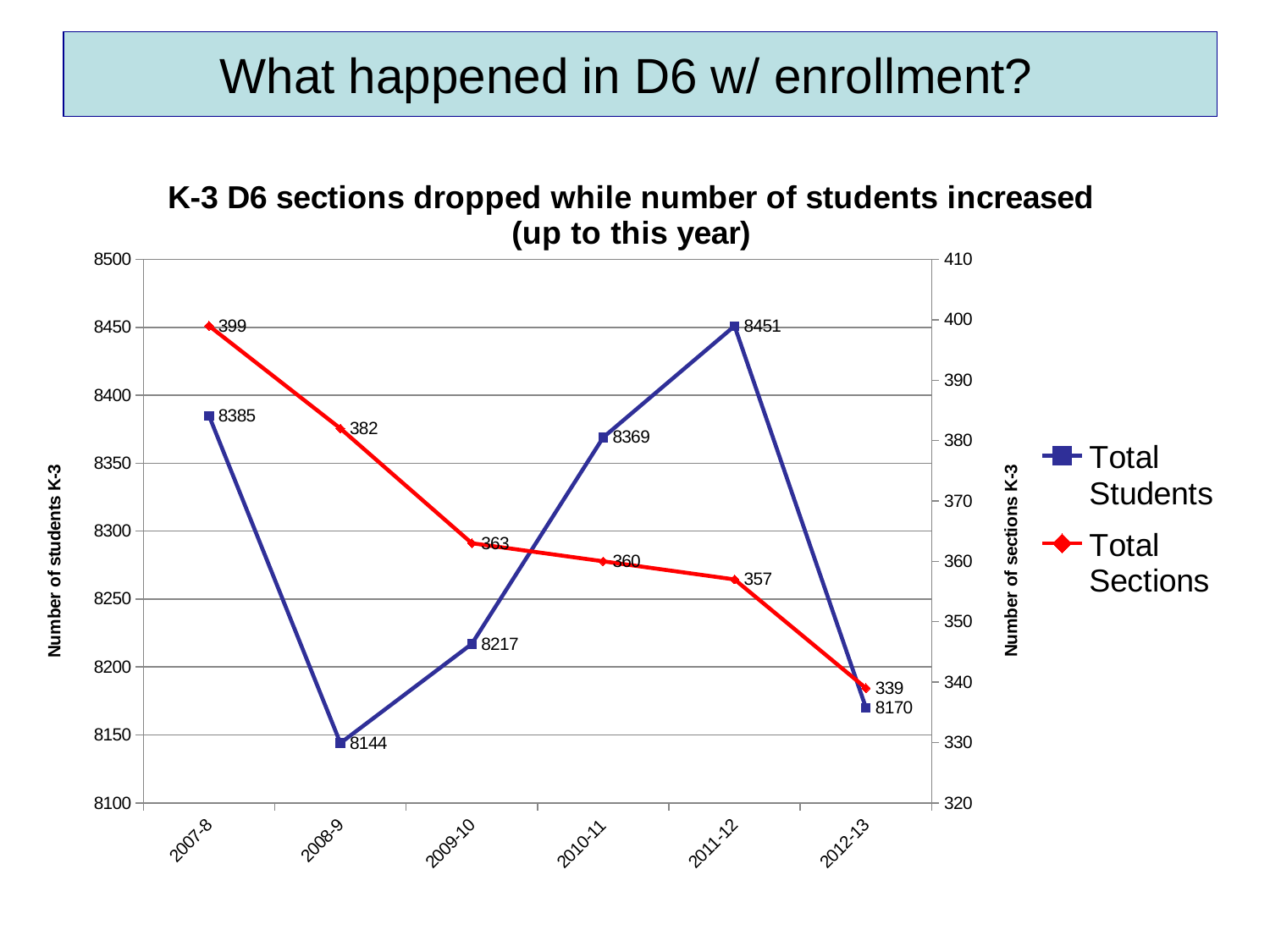
Which year has the lowest value for Total Students? 2008-9 Which year has the highest value for Total Sections? 2007-8 What is the difference between Total Students in 2011-12 and 2012-13? 281 What is the difference between Total Sections in 2007-8 and 2012-13? 60 What is the value for Total Students in 2011-12? 8451 What kind of chart is this? line chart How many years are shown on the x axis? 6 Which is larger, Total Students in 2010-11 or in 2009-10? 2010-11 What is the value for Total Sections in 2009-10? 363 Do the Total Sections values rise or fall from 2007-8 to 2012-13? fall What is the value for Total Students in 2008-9? 8144 How many series does the legend list? 2